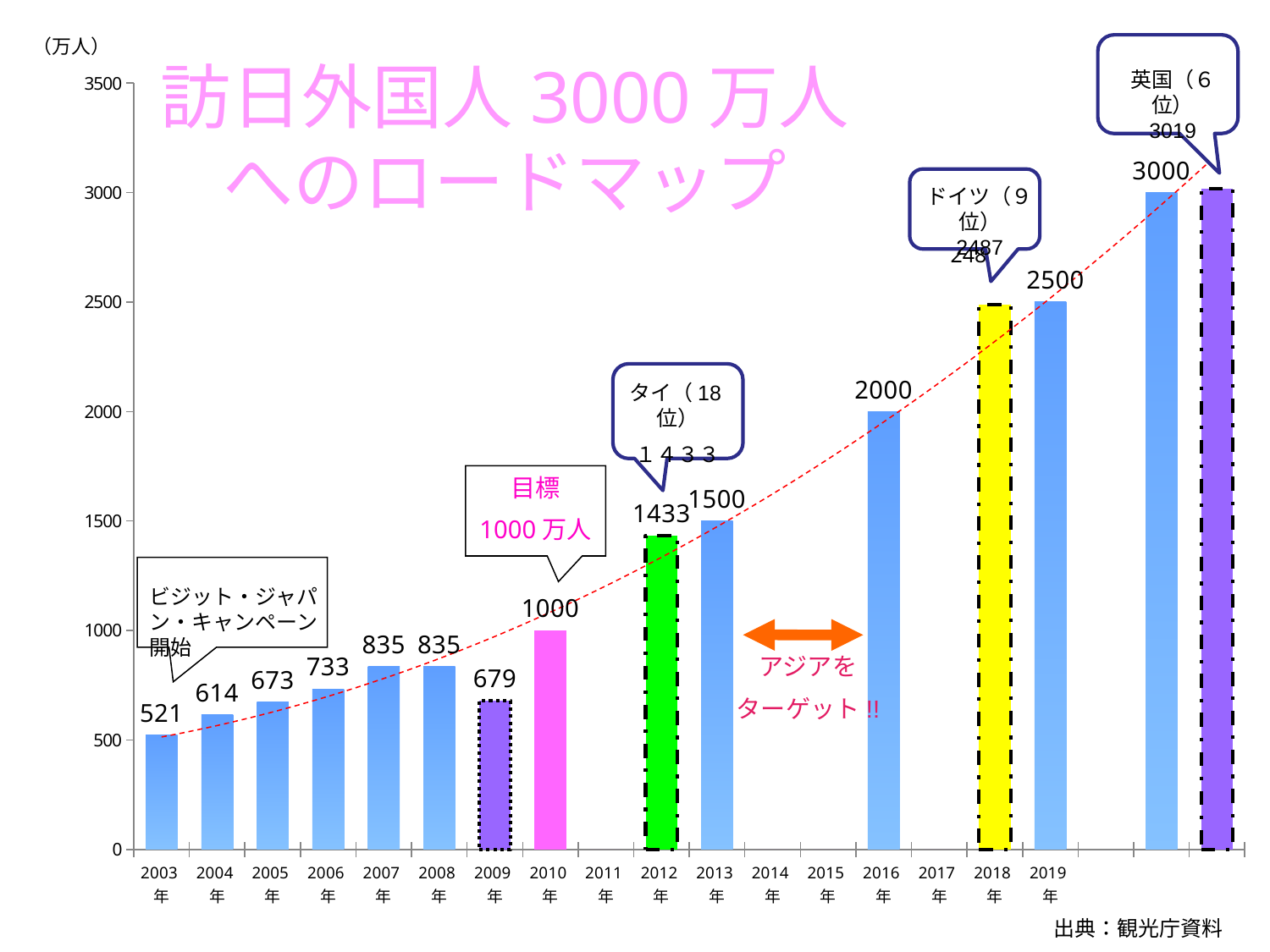
Which is larger, the value for 2007年 or the value for 2009年? 2007年 What unit is shown at the top of the y axis? 万人 Do the values generally rise or fall from 2003年 to 2019年? rise What is the value for 2012年? 1433 Which year has the lowest value on the chart? 2003年 What is the value for 2009年? 679 What is the value for 2010年? 1000 What is the value for 2003年? 521 What is the value for 2016年? 2000 Is the value for 2018年 greater or less than 2000? greater What is the difference between the values for 2013年 and 2012年? 67 What kind of chart is shown on the slide? bar chart